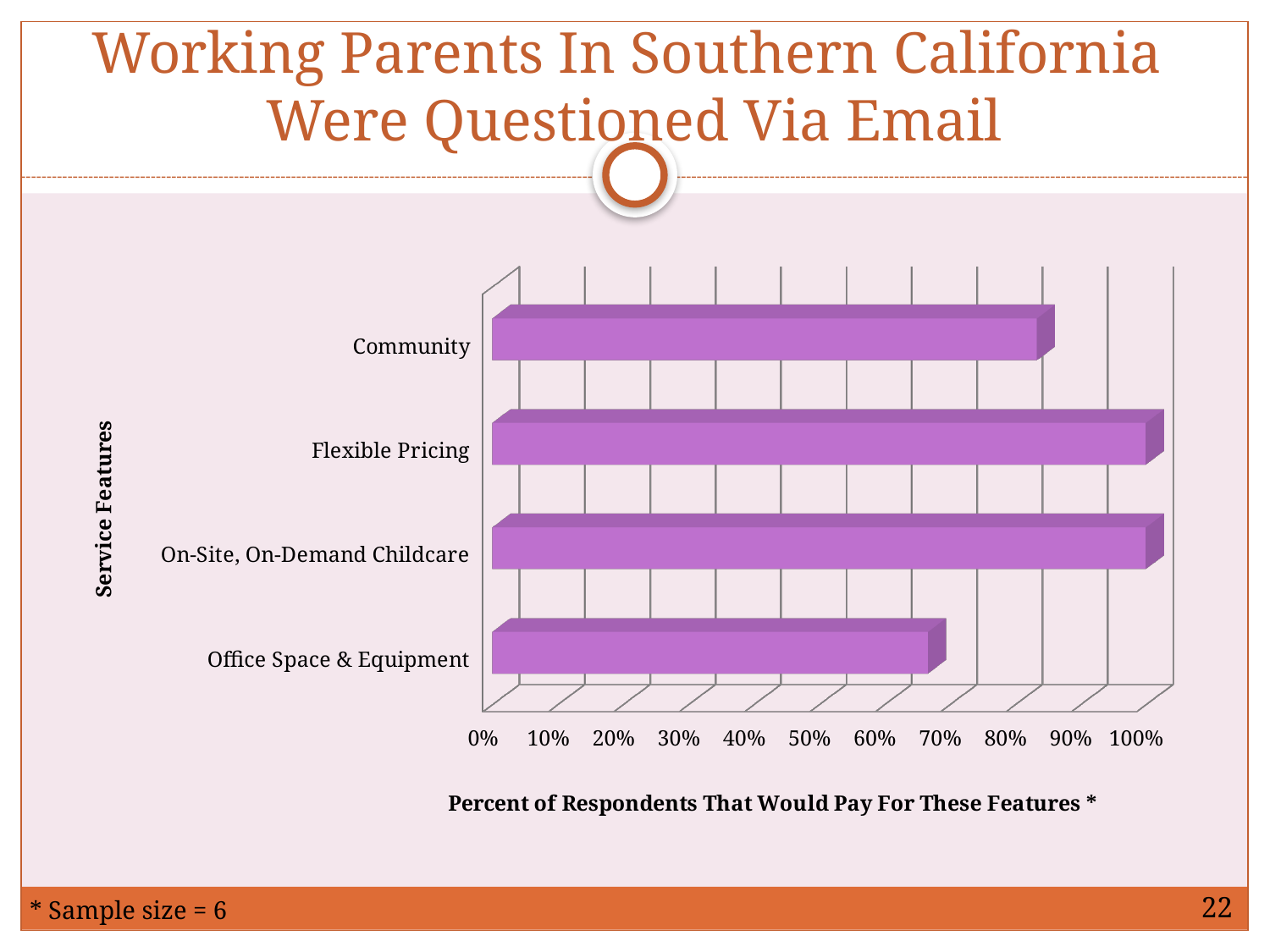
What kind of chart is shown on the slide? Bar chart Is the value for On-Site, On-Demand Childcare greater or less than 90%? greater How many service features are plotted in the chart? 4 Is the value for Flexible Pricing greater or less than 90%? greater Is the value for Community greater or less than 90%? less Which is larger, the value for Flexible Pricing or the value for Community? Flexible Pricing What is the title of the vertical axis of the chart? Service Features Which service feature has the lowest percent of respondents that would pay for it? Office Space & Equipment Which is larger, the value for Community or the value for Office Space & Equipment? Community What is the title of the horizontal axis of the chart? Percent of Respondents That Would Pay For These Features *